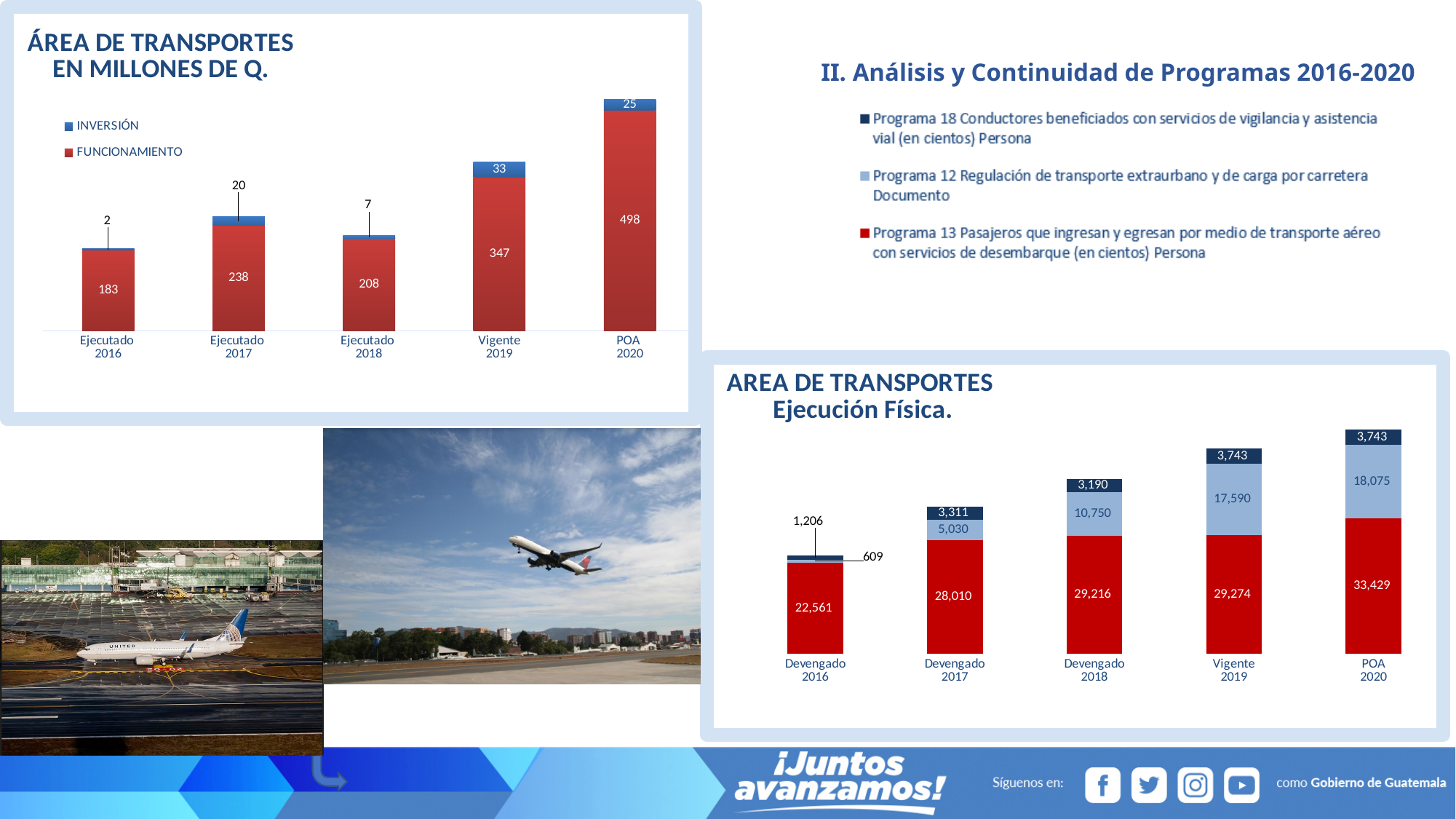
In the chart titled 'ÁREA DE TRANSPORTES EN MILLONES DE Q.', what is the FUNCIONAMIENTO value for Vigente 2019? 347 In the chart titled 'AREA DE TRANSPORTES Ejecución Física.', which is larger, the Programa 12 value for Vigente 2019 or for POA 2020? POA 2020 In the chart titled 'ÁREA DE TRANSPORTES EN MILLONES DE Q.', how many series does the legend list? 2 In the chart titled 'AREA DE TRANSPORTES Ejecución Física.', what is the total of the stacked bar for Devengado 2016? 24,376 In the chart titled 'AREA DE TRANSPORTES Ejecución Física.', what is the Programa 12 value for Devengado 2018? 10,750 In the chart titled 'ÁREA DE TRANSPORTES EN MILLONES DE Q.', what is the difference between the FUNCIONAMIENTO values for Ejecutado 2017 and Ejecutado 2018? 30 In the chart titled 'AREA DE TRANSPORTES Ejecución Física.', what is the Programa 13 value for POA 2020? 33,429 In the chart titled 'ÁREA DE TRANSPORTES EN MILLONES DE Q.', which category has the lowest INVERSIÓN value? Ejecutado 2016 In the chart titled 'ÁREA DE TRANSPORTES EN MILLONES DE Q.', what is the INVERSIÓN value for Ejecutado 2017? 20 In the chart titled 'ÁREA DE TRANSPORTES EN MILLONES DE Q.', what is the total of the stacked bar for POA 2020? 523 In the chart titled 'ÁREA DE TRANSPORTES EN MILLONES DE Q.', which category has the highest FUNCIONAMIENTO value? POA 2020 What kind of chart is the one titled 'AREA DE TRANSPORTES Ejecución Física.'? Stacked bar chart